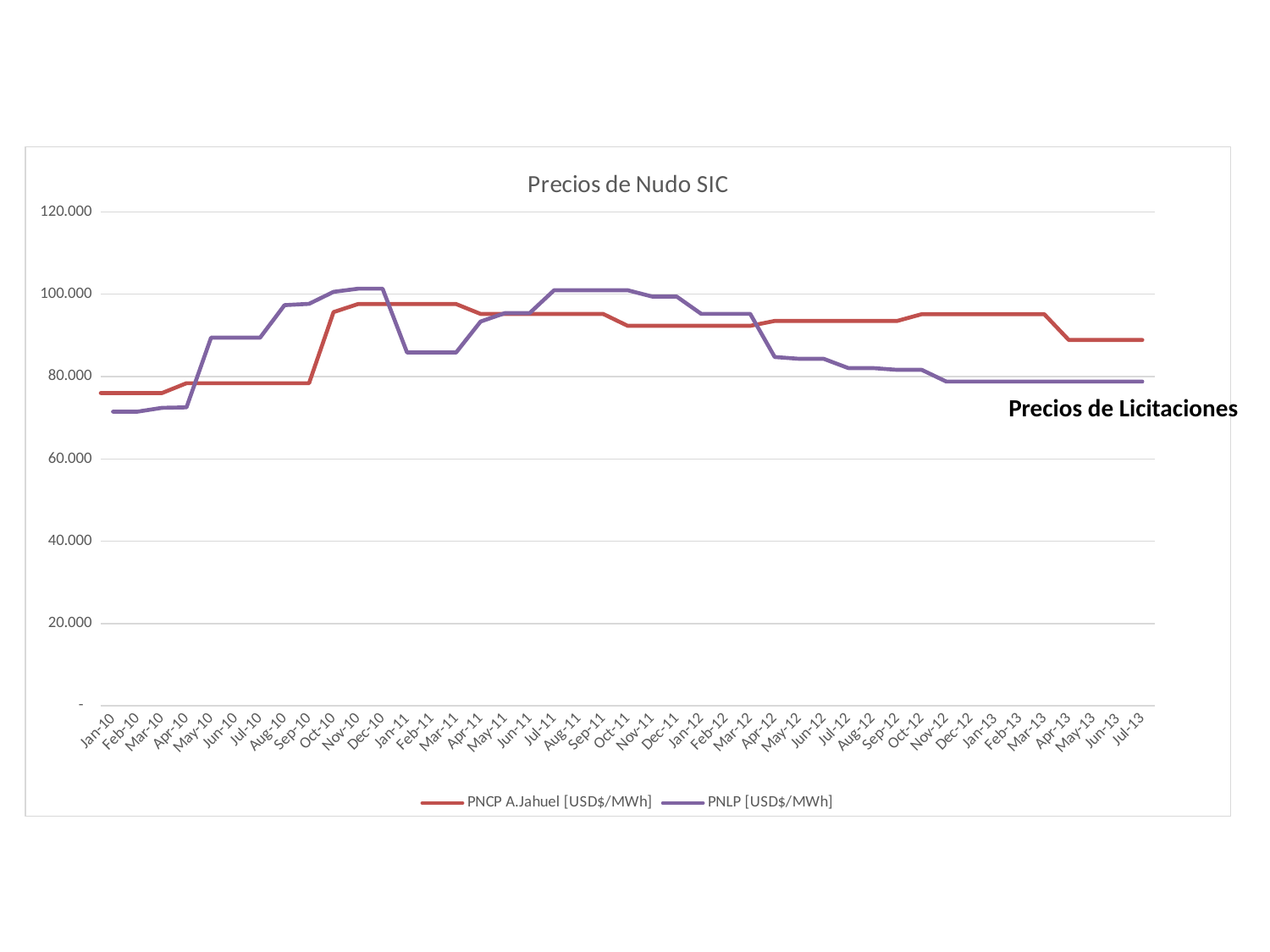
Is the value for PNCP A.Jahuel [USD$/MWh] in Jul-13 greater or less than 80.000? greater Is the value for PNCP A.Jahuel [USD$/MWh] in Oct-10 greater or less than 80.000? greater How many monthly points are plotted along the x axis, from Jan-10 to Jul-13? 43 Which series is drawn in purple? PNLP [USD$/MWh] Does the PNLP [USD$/MWh] series generally rise or fall from Apr-12 to Jul-13? fall In Jul-13, which series has the higher value, PNCP A.Jahuel [USD$/MWh] or PNLP [USD$/MWh]? PNCP A.Jahuel [USD$/MWh] Is the value for PNLP [USD$/MWh] in Feb-11 greater or less than 80.000? greater What kind of chart is shown on the slide? line chart In Jun-10, which series has the higher value, PNCP A.Jahuel [USD$/MWh] or PNLP [USD$/MWh]? PNLP [USD$/MWh] How many series does the legend list? 2 What is the title of the chart? Precios de Nudo SIC